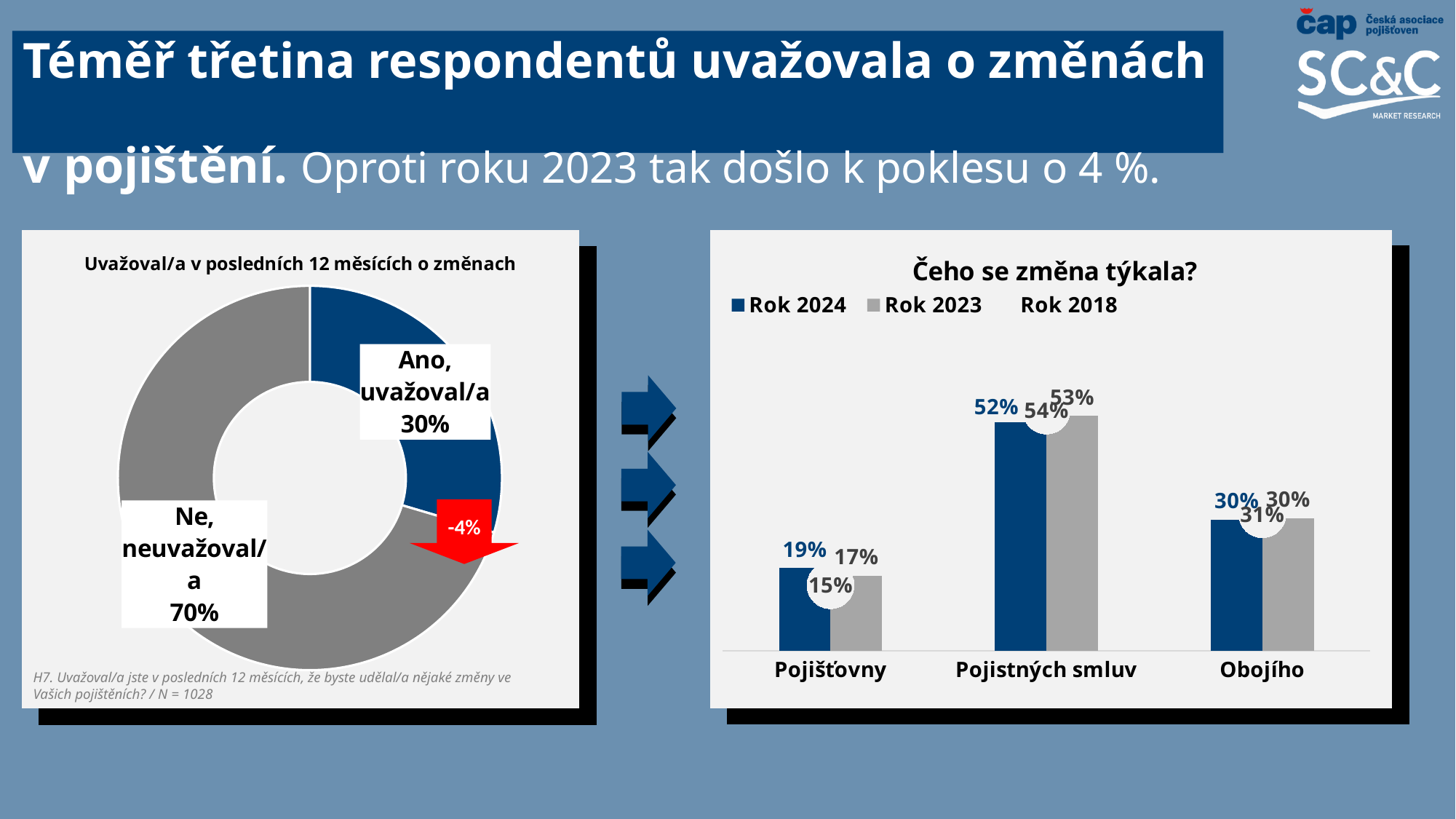
In the chart "Čeho se změna týkala?", what is the difference between the Rok 2024 and Rok 2023 values for Pojišťovny? 2% In the donut chart on the left, what share of respondents answered "Ano, uvažoval/a"? 30% In the chart "Čeho se změna týkala?", what is the value for Pojišťovny in Rok 2024? 19% In the chart "Čeho se změna týkala?", what is the value for Obojího in Rok 2023? 30% In the donut chart on the left, how many slices are there? 2 What type of chart is the chart titled "Čeho se změna týkala?"? Bar chart In the chart "Čeho se změna týkala?", how many series does the legend list? 3 In the donut chart on the left, what share of respondents answered "Ne, neuvažoval/a"? 70% In the chart "Čeho se změna týkala?", what is the value for Pojistných smluv in Rok 2024? 52% What type of chart is the chart on the left titled "Uvažoval/a v posledních 12 měsících o změnach"? Donut (pie) chart In the chart "Čeho se změna týkala?", which category has the highest value for Rok 2024? Pojistných smluv In the chart "Čeho se změna týkala?", what is the value for Pojišťovny in Rok 2018? 15%